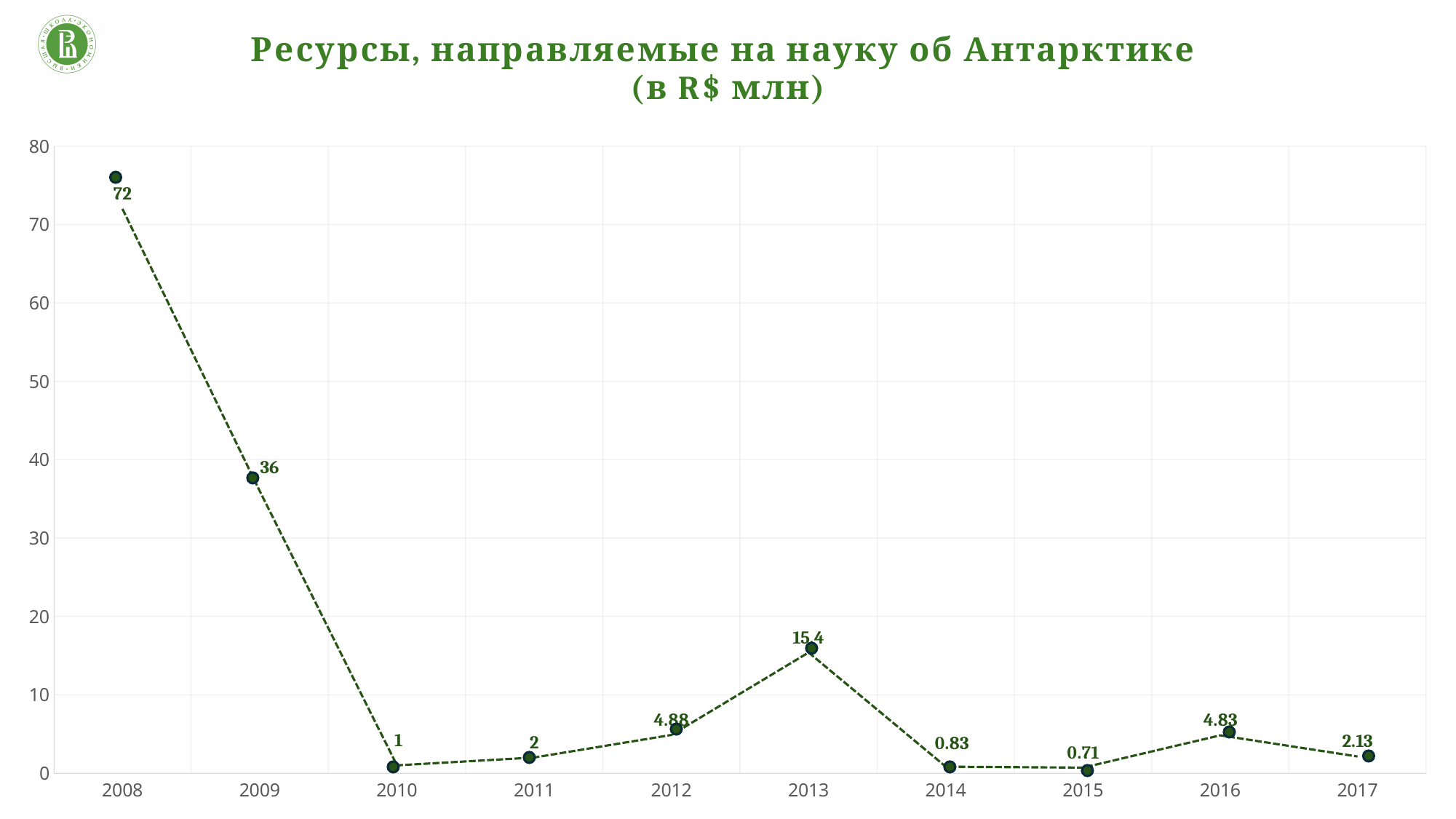
How many years are plotted on the chart? 10 What is the value for 2015? 0.71 Is the value for 2009 greater or less than 30? greater Which year has the lowest value? 2015 What is the title of the chart? Ресурсы, направляемые на науку об Антарктике (в R$ млн) What is the value for 2008? 72 What is the value for 2017? 2.13 Which is larger, the value for 2012 or the value for 2016? 2012 What is the difference between the values for 2008 and 2009? 36 What type of chart is shown on the slide? line chart Which year has the highest value? 2008 What is the value for 2013? 15.4